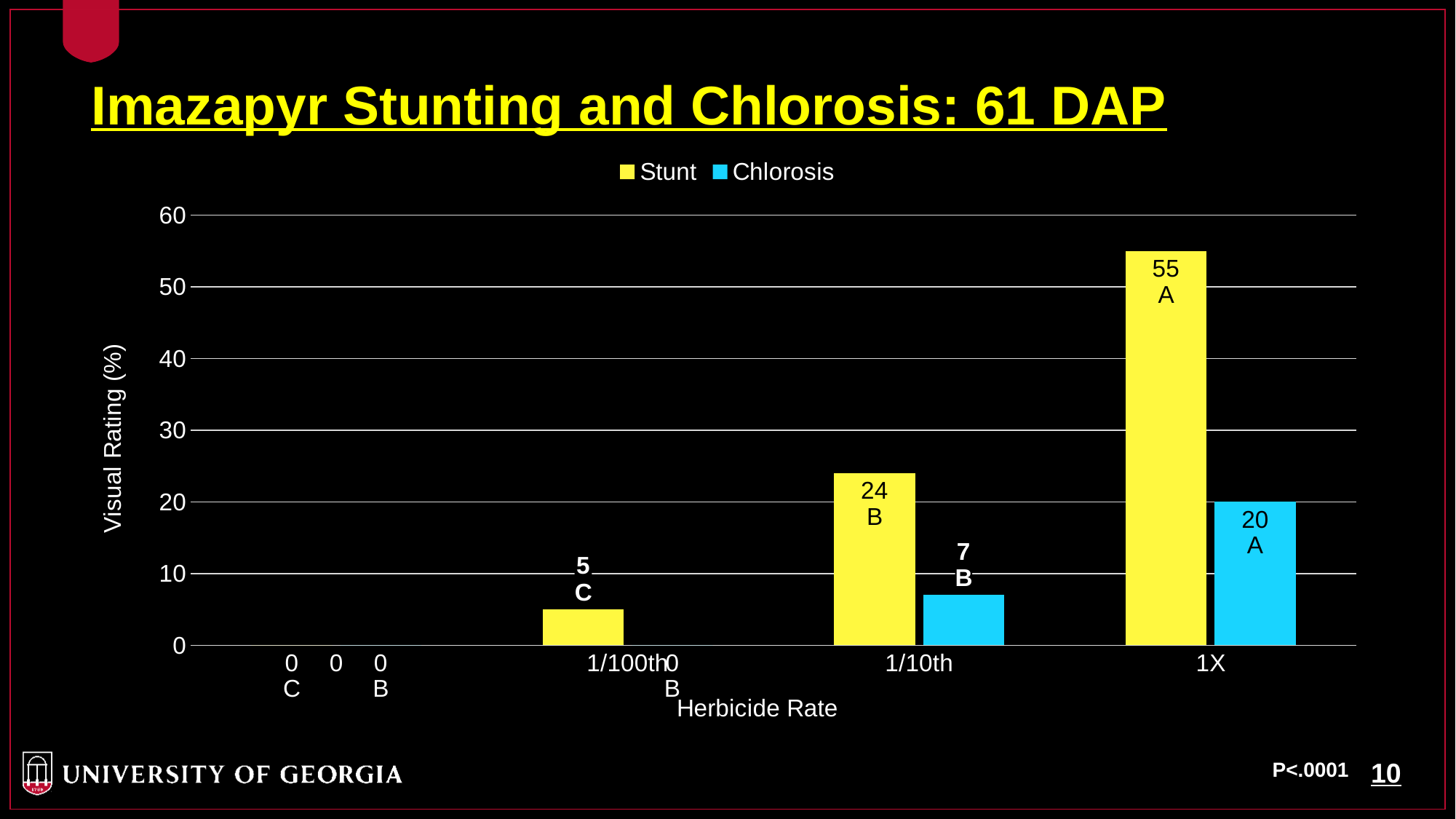
What is the difference between the Stunt values at 1X and 1/10th? 31 What is the difference between the Stunt and Chlorosis values at the 1X rate? 35 What is the Chlorosis value at the 1X herbicide rate? 20 Do the Stunt values rise or fall as the herbicide rate increases from 0 to 1X? Rise Which herbicide rate has the highest Stunt value? 1X How many series does the legend list? 2 How many herbicide rate categories are shown on the x axis? 4 What is the Stunt value at the 1X herbicide rate? 55 What kind of chart is shown on the slide? Bar chart What is the Stunt value at the 1/100th herbicide rate? 5 Which is larger at the 1/10th rate, Stunt or Chlorosis? Stunt What is the Chlorosis value at the 1/10th herbicide rate? 7